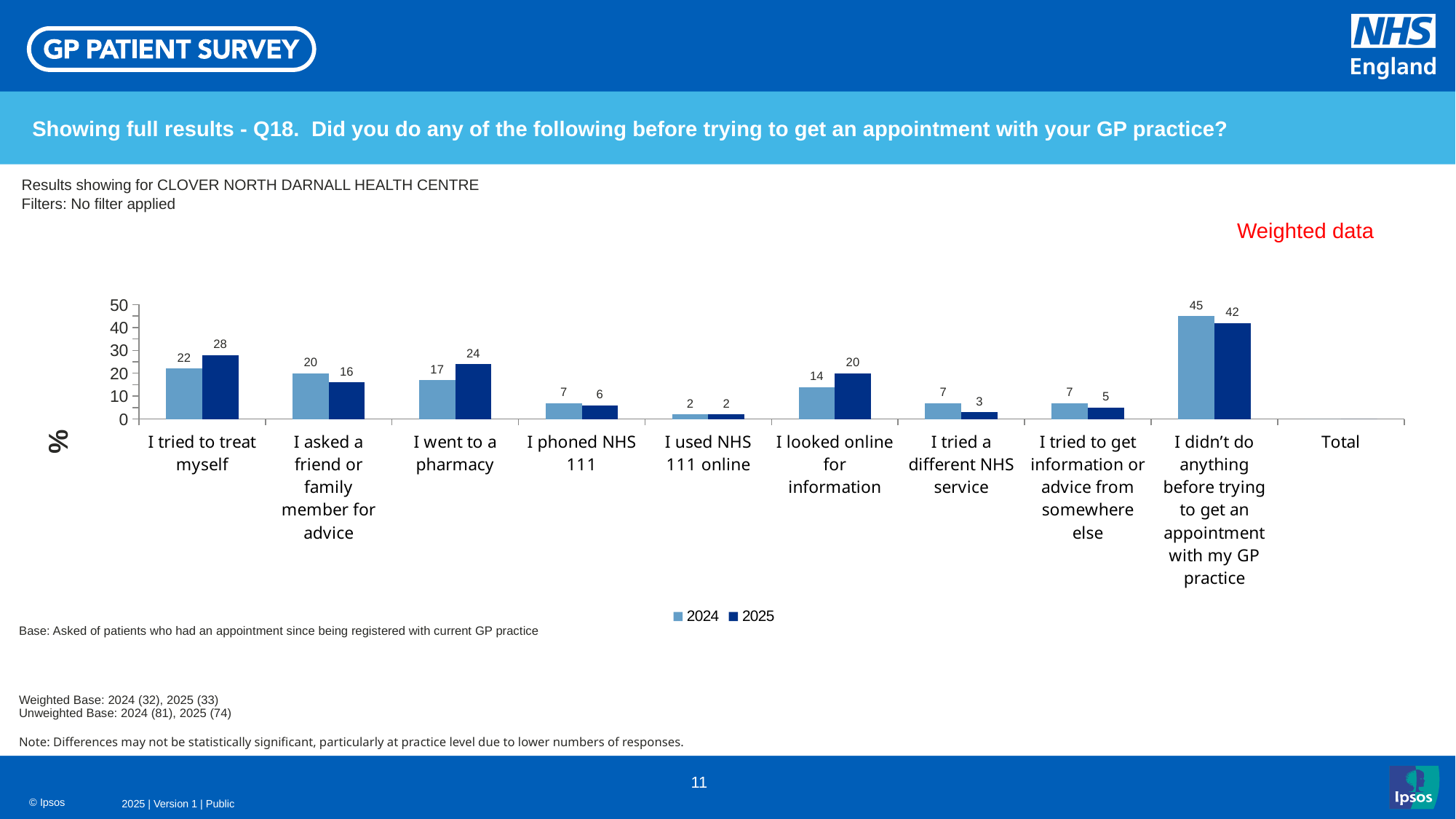
What are the two series named in the legend? 2024 and 2025 How many series does the legend list? 2 Which category has the lowest 2025 value? I used NHS 111 online What is the 2025 value for "I tried to treat myself"? 28 What is the 2024 value for "I went to a pharmacy"? 17 Which category has the highest 2024 value? I didn't do anything before trying to get an appointment with my GP practice Is the 2025 value for "I didn't do anything before trying to get an appointment with my GP practice" greater or less than 30? greater What is the difference between the 2025 and 2024 values for "I went to a pharmacy"? 7 What is the 2025 value for "I looked online for information"? 20 What kind of chart is shown on the slide? Bar chart What is the difference between the 2024 and 2025 values for "I asked a friend or family member for advice"? 4 Which is larger for "I tried a different NHS service": the 2024 value or the 2025 value? 2024